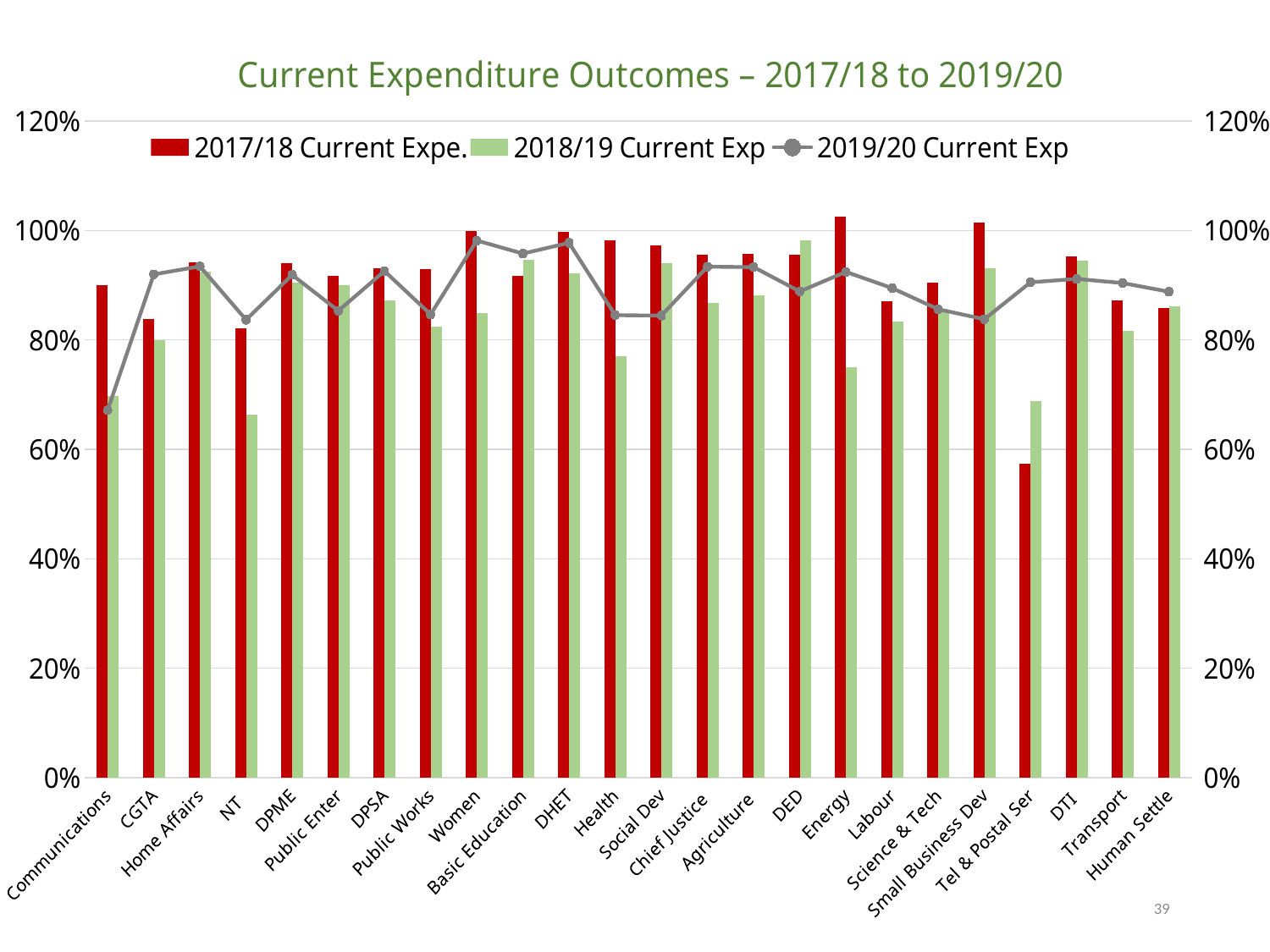
Is the 2017/18 Current Expe. value for Tel & Postal Ser greater or less than 60%? less Is the 2017/18 Current Expe. value for Energy greater or less than 100%? greater How many series does the legend list? 3 Which category has the lowest 2017/18 Current Expe. value? Tel & Postal Ser Is the 2019/20 Current Exp value for Communications greater or less than 80%? less Which category has the lowest 2019/20 Current Exp value? Communications For Health, which is larger: the 2017/18 Current Expe. value or the 2018/19 Current Exp value? 2017/18 Current Expe. How many categories are shown on the x axis? 24 What is the title of the chart? Current Expenditure Outcomes – 2017/18 to 2019/20 For Tel & Postal Ser, which is larger: the 2017/18 Current Expe. value or the 2018/19 Current Exp value? 2018/19 Current Exp What kind of chart is this? Bar chart with a line series